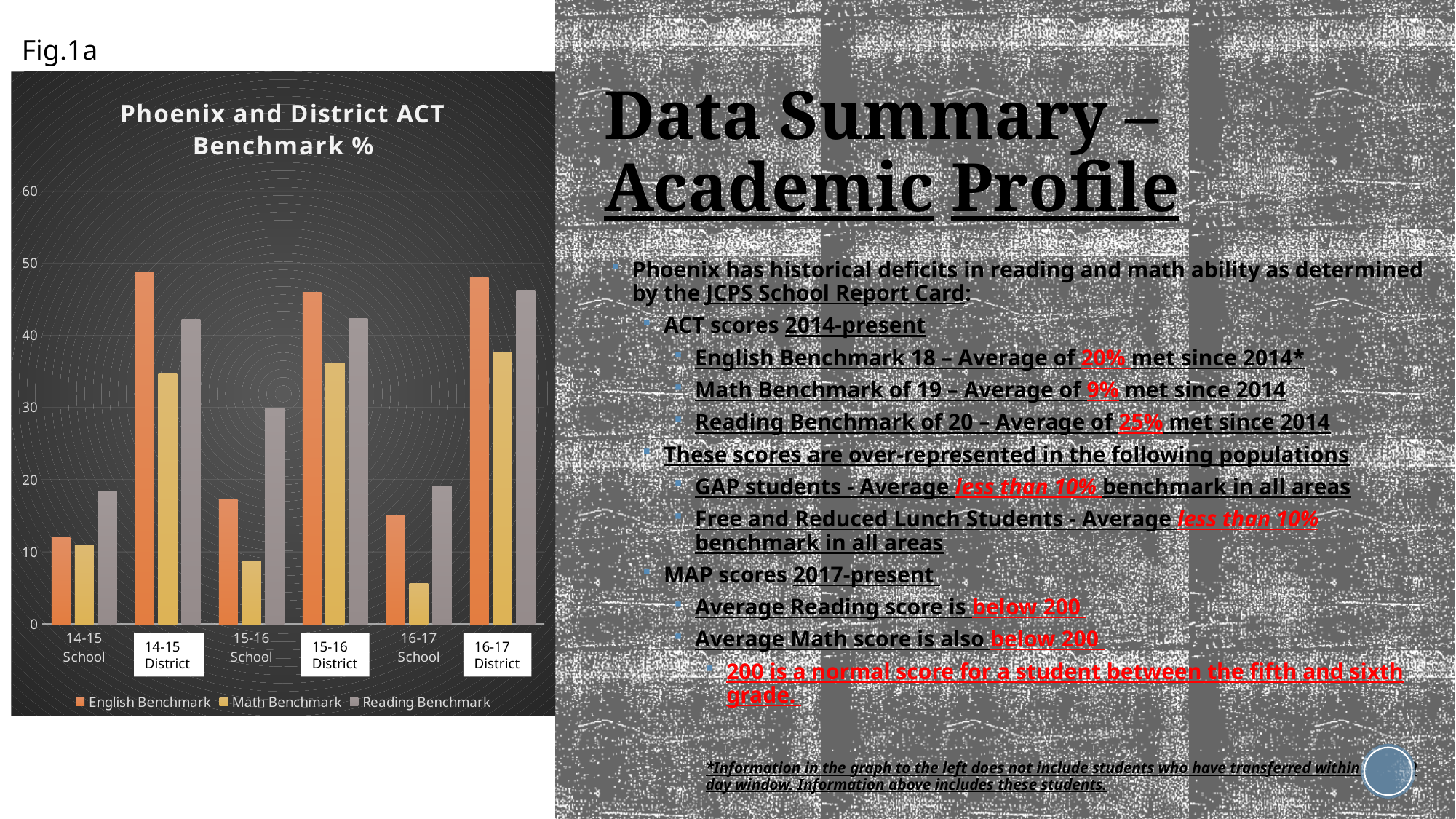
Which is larger, the Reading Benchmark for 15-16 School or the Reading Benchmark for 16-17 School? 15-16 School Is the English Benchmark value for 14-15 District greater or less than 40? greater How many series does the chart's legend list? 3 Is the Reading Benchmark value for 15-16 School greater or less than 20? greater What kind of chart is shown on the slide? bar chart Which category has the highest Reading Benchmark value? 16-17 District What is the title of the chart? Phoenix and District ACT Benchmark % Within the 14-15 District category, which series has the lowest value? Math Benchmark Is the Math Benchmark value for 16-17 School greater or less than 10? less Which series is shown in orange in the chart? English Benchmark How many categories are shown along the x axis of the chart? 6 Which category has the lowest Math Benchmark value? 16-17 School